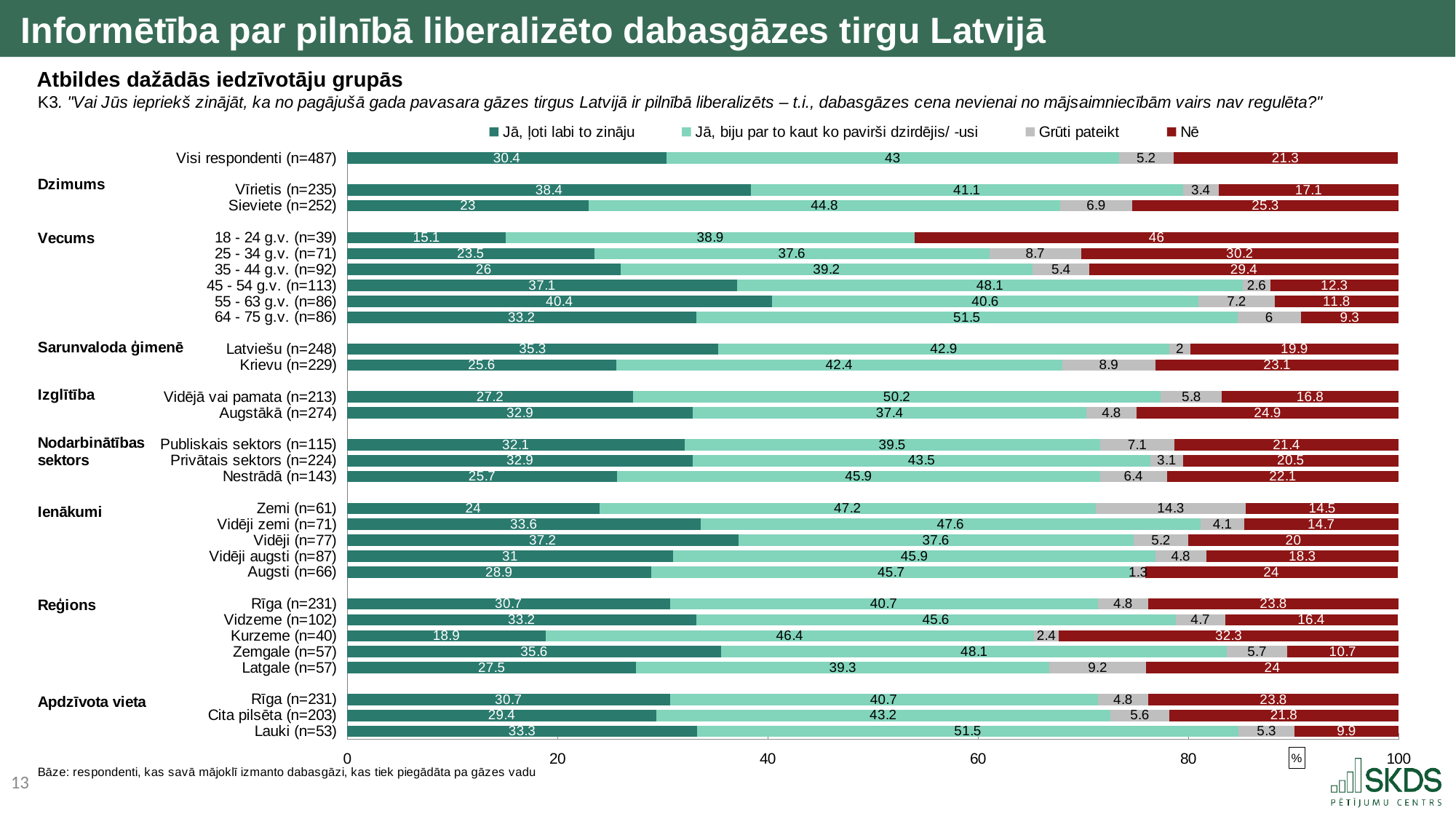
How many series does the legend list? 4 What is the value of "Grūti pateikt" for Zemi (n=61)? 14.3 How many respondent groups (bars) are shown in the chart? 29 What is the difference between Vīrietis (n=235) and Sieviete (n=252) for "Jā, ļoti labi to zināju"? 15.4 Which group has the highest value for "Jā, ļoti labi to zināju"? 55 - 63 g.v. (n=86) What is the value of "Jā, ļoti labi to zināju" for Visi respondenti (n=487)? 30.4 What is the value of "Nē" for Zemgale (n=57)? 10.7 What kind of chart is shown on the slide? Stacked bar chart Which has the larger value for "Jā, ļoti labi to zināju": Latviešu (n=248) or Krievu (n=229)? Latviešu (n=248) What is the total of the stacked bar for Lauki (n=53)? 100 Which group has the lowest value for "Jā, ļoti labi to zināju"? 18 - 24 g.v. (n=39) Which group has the highest value for "Nē"? 18 - 24 g.v. (n=39)